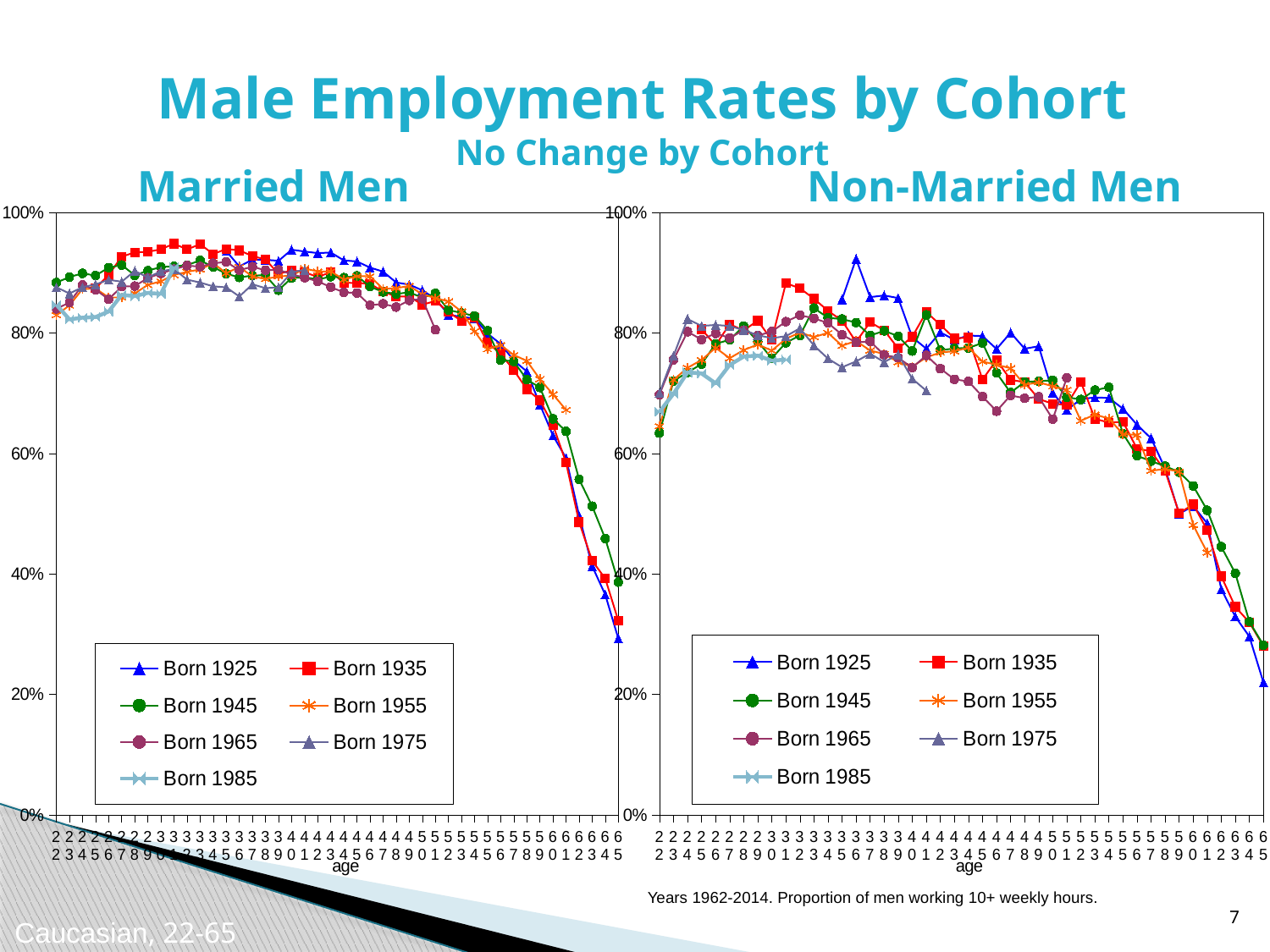
What is the subtitle shown under the main title of the slide? No Change by Cohort What kind of chart is the Married Men chart? line chart In the Non-Married Men chart, is the value for Born 1925 at age 65 greater or less than 40%? less In the Married Men chart, is the value for Born 1935 at age 30 greater or less than 80%? greater How many series does the legend of the Non-Married Men chart list? 7 In the Non-Married Men chart, does the Born 1935 series rise or fall between age 50 and age 65? fall In the Married Men chart at age 65, which is larger: Born 1945 or Born 1925? Born 1945 What is the x-axis label on the Married Men chart? age In the Married Men chart, is the value for Born 1925 at age 65 greater or less than 40%? less In the Married Men chart, does the Born 1925 series rise or fall between age 45 and age 65? fall